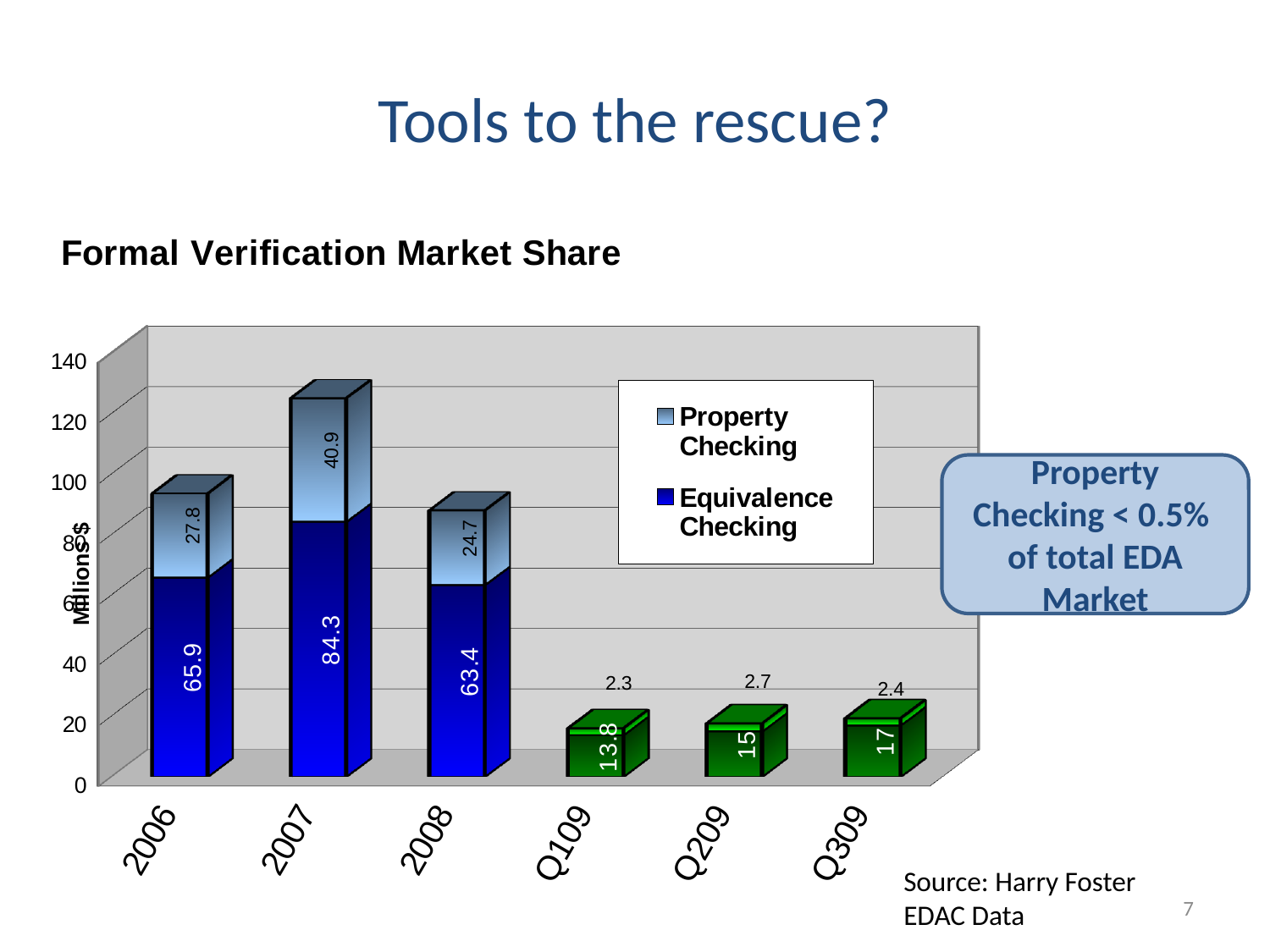
What is the Equivalence Checking value for Q309? 17 What is the difference between the Equivalence Checking values for 2007 and 2006? 18.4 Which category has the highest Property Checking value? 2007 What kind of chart is shown on the slide? Stacked bar chart What is the Property Checking value for 2008? 24.7 Which category has the lowest Equivalence Checking value? Q109 What is the Equivalence Checking value for 2007? 84.3 Which is larger, the Property Checking value for 2006 or for 2008? 2006 What is the total of the stacked bar for Q209? 17.7 How many series does the legend list? 2 How many categories are shown on the x axis? 6 What is the total of the stacked bar for 2007? 125.2